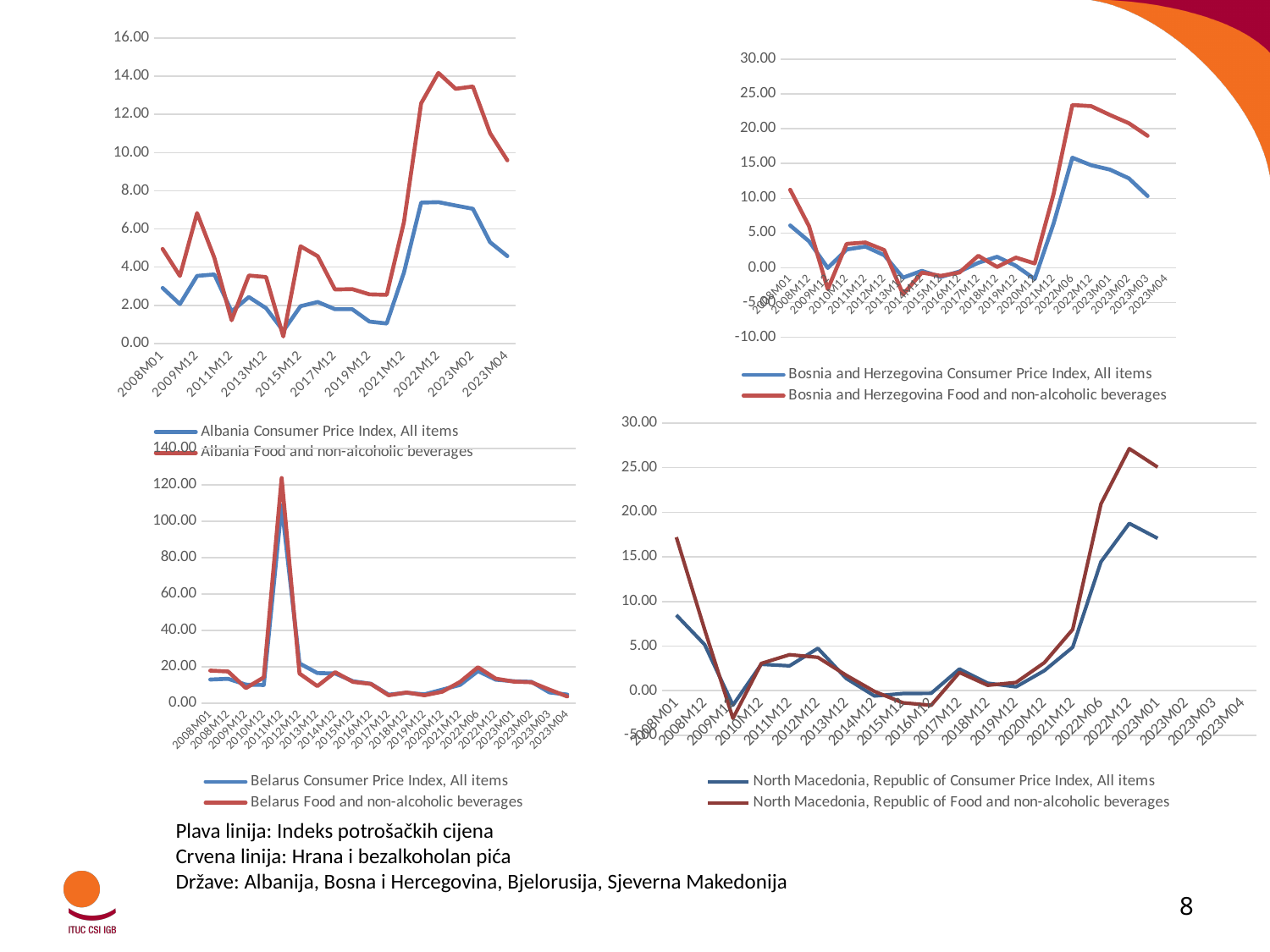
In the bottom-left chart (Belarus), is the peak value of the Food and non-alcoholic beverages line at 2011M12 greater or less than 100.00? greater In the bottom-left chart (Belarus), at which x-axis label do both lines reach their peak? 2011M12 How many series does the legend of the bottom-left chart (Belarus) list? 2 Which colour is used for the Consumer Price Index, All items line in the top-left chart (Albania)? blue In the top-right chart (Bosnia and Herzegovina), do the values of the Food and non-alcoholic beverages line rise or fall between 2022M06 and 2023M03? fall In the top-right chart (Bosnia and Herzegovina), is the peak value of the Food and non-alcoholic beverages line greater or less than 20.00? greater In the top-left chart (Albania), which series is higher at 2022M12: Consumer Price Index, All items or Food and non-alcoholic beverages? Food and non-alcoholic beverages What kind of chart is the top-left chart (Albania)? line chart In the top-left chart (Albania), is the value of the Food and non-alcoholic beverages line at 2022M12 greater or less than 12.00? greater